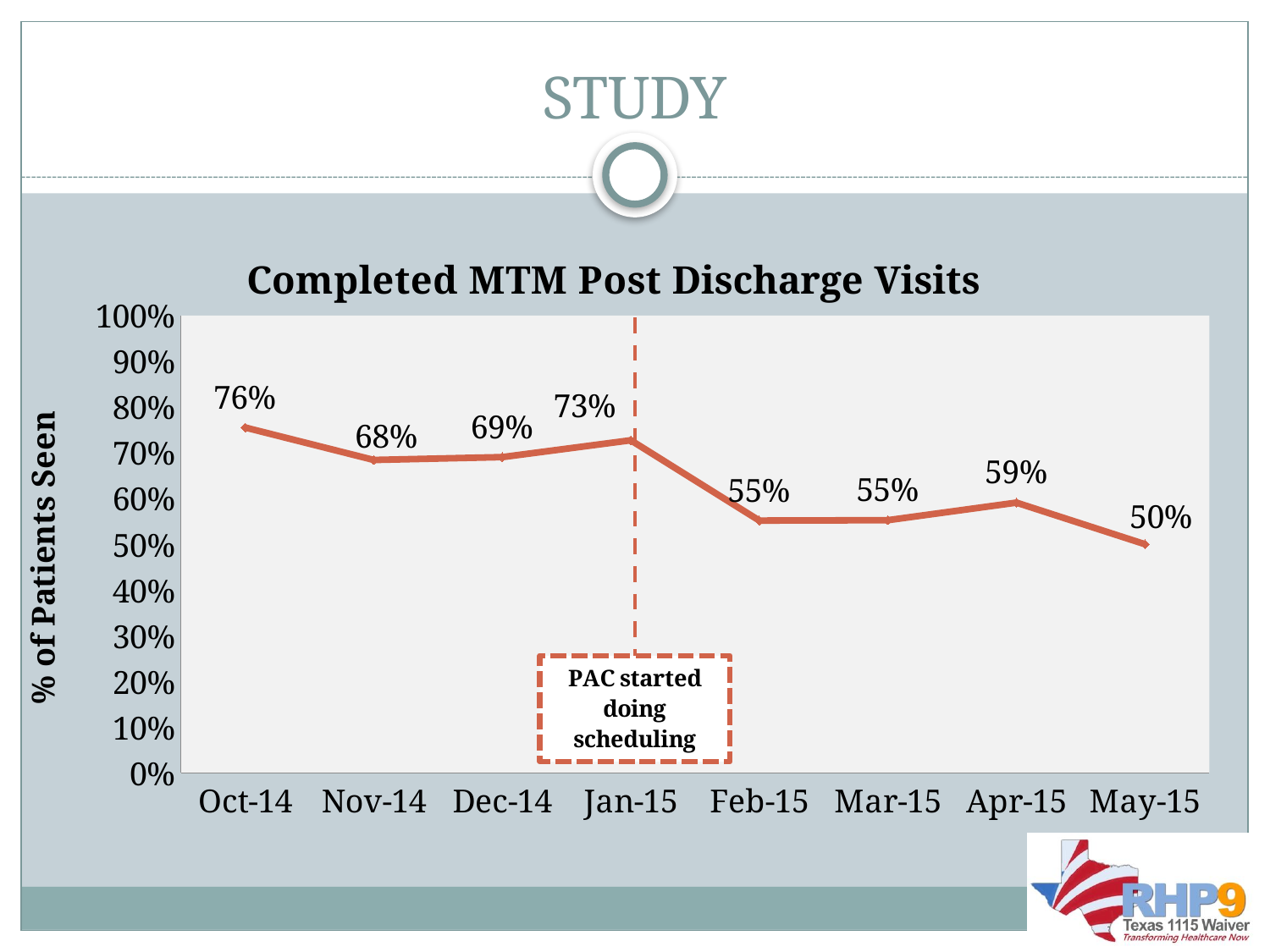
What is the difference between the values for Oct-14 and May-15? 26% Which is larger, the value for Apr-15 or the value for Mar-15? Apr-15 What kind of chart is shown on the slide? line chart Is the value for Dec-14 greater or less than 60%? greater What is the value for May-15? 50% What is the difference between the values for Jan-15 and Feb-15? 18% Which month has the highest percentage of patients seen? Oct-14 How many months are plotted on the chart? 8 What is the title of the chart? Completed MTM Post Discharge Visits Which month has the lowest percentage of patients seen? May-15 What is the value for Oct-14? 76% What is the value for Jan-15? 73%